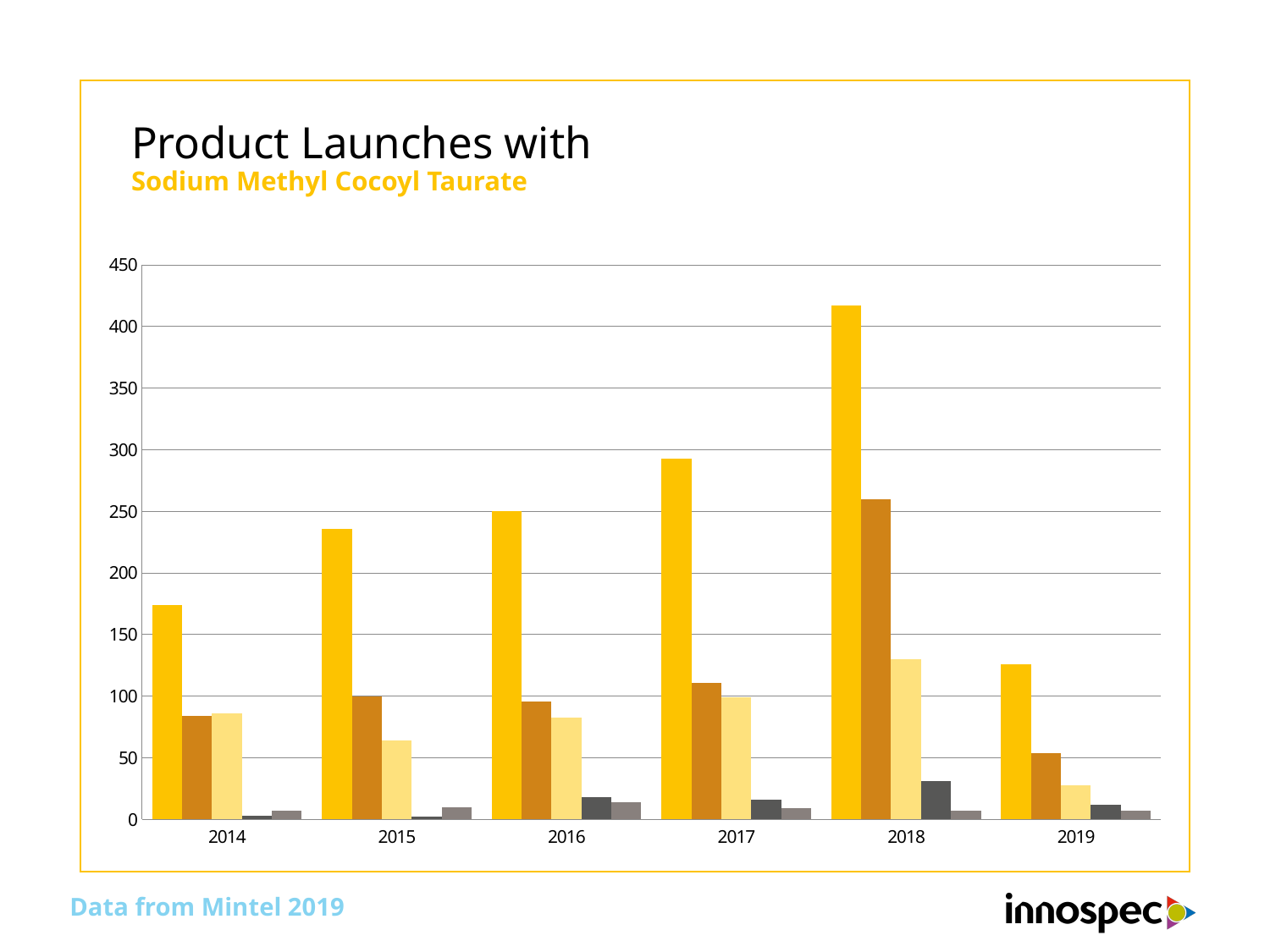
In which year is the bright yellow (first) bar the lowest? 2019 Is the value of the bright yellow bar for 2018 greater or less than 400? greater Is the value of the pale yellow (third) bar for 2015 greater or less than 100? less How many years are shown along the x axis? 6 Which is larger, the bright yellow bar for 2016 or the bright yellow bar for 2017? 2017 Do the bright yellow bars rise or fall from 2014 to 2018? rise What ingredient is named in the chart's subtitle? Sodium Methyl Cocoyl Taurate Is the value of the orange (second) bar for 2018 greater or less than 200? greater In which year is the tallest bar on the chart? 2018 What kind of chart is shown on the slide? bar chart